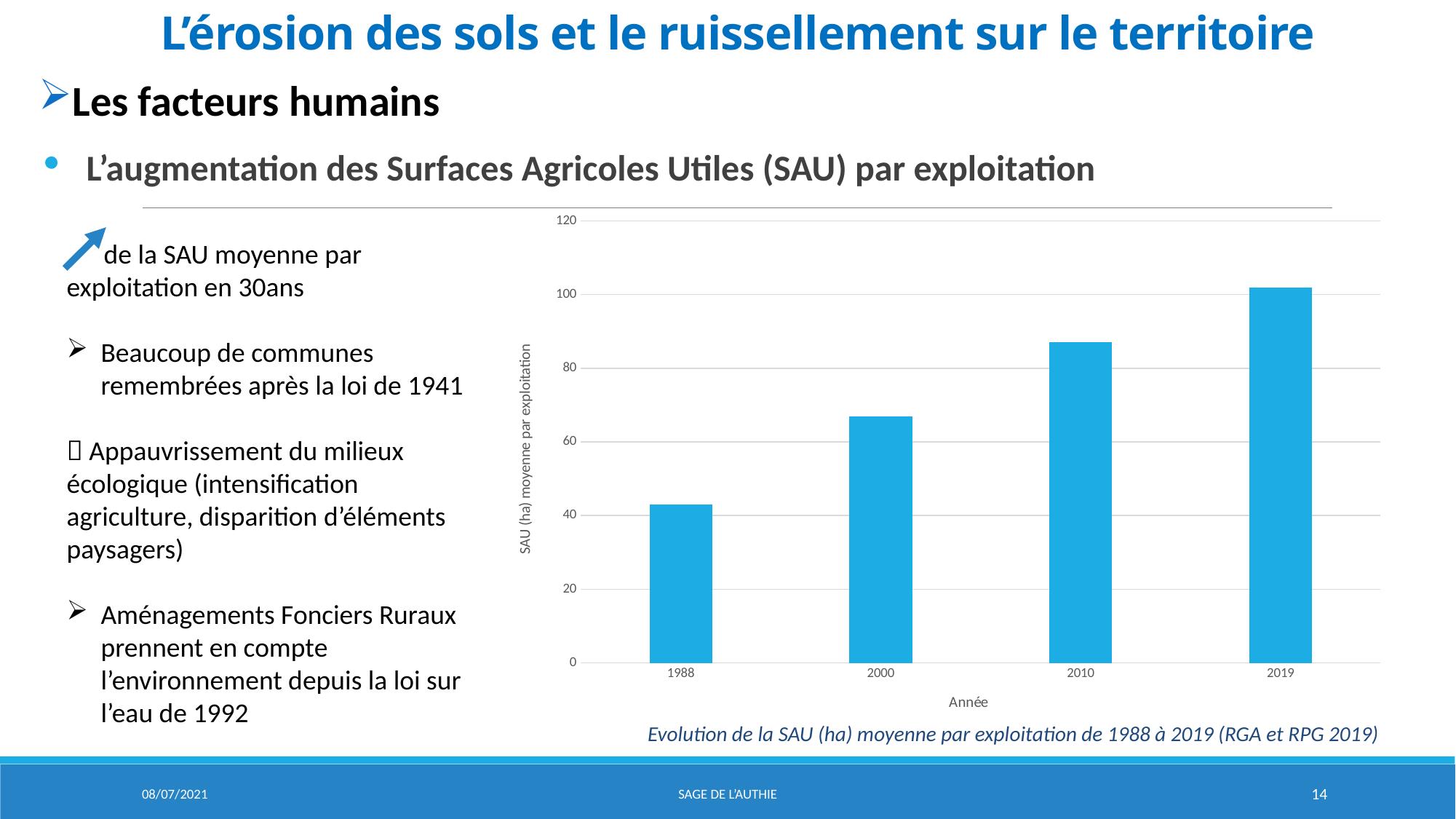
What is the label of the vertical axis of the chart? SAU (ha) moyenne par exploitation Which year has the highest average SAU per exploitation? 2019 How many years (bars) are plotted in the chart? 4 Is the value for 2000 greater or less than 80? less What kind of chart is shown on the slide? bar chart Which is larger, the value for 2000 or the value for 2010? 2010 Do the values rise or fall from 1988 to 2019? rise Is the value for 1988 greater or less than 60? less What is the label of the horizontal axis of the chart? Année Which year has the lowest average SAU per exploitation? 1988 Is the value for 2010 greater or less than 80? greater